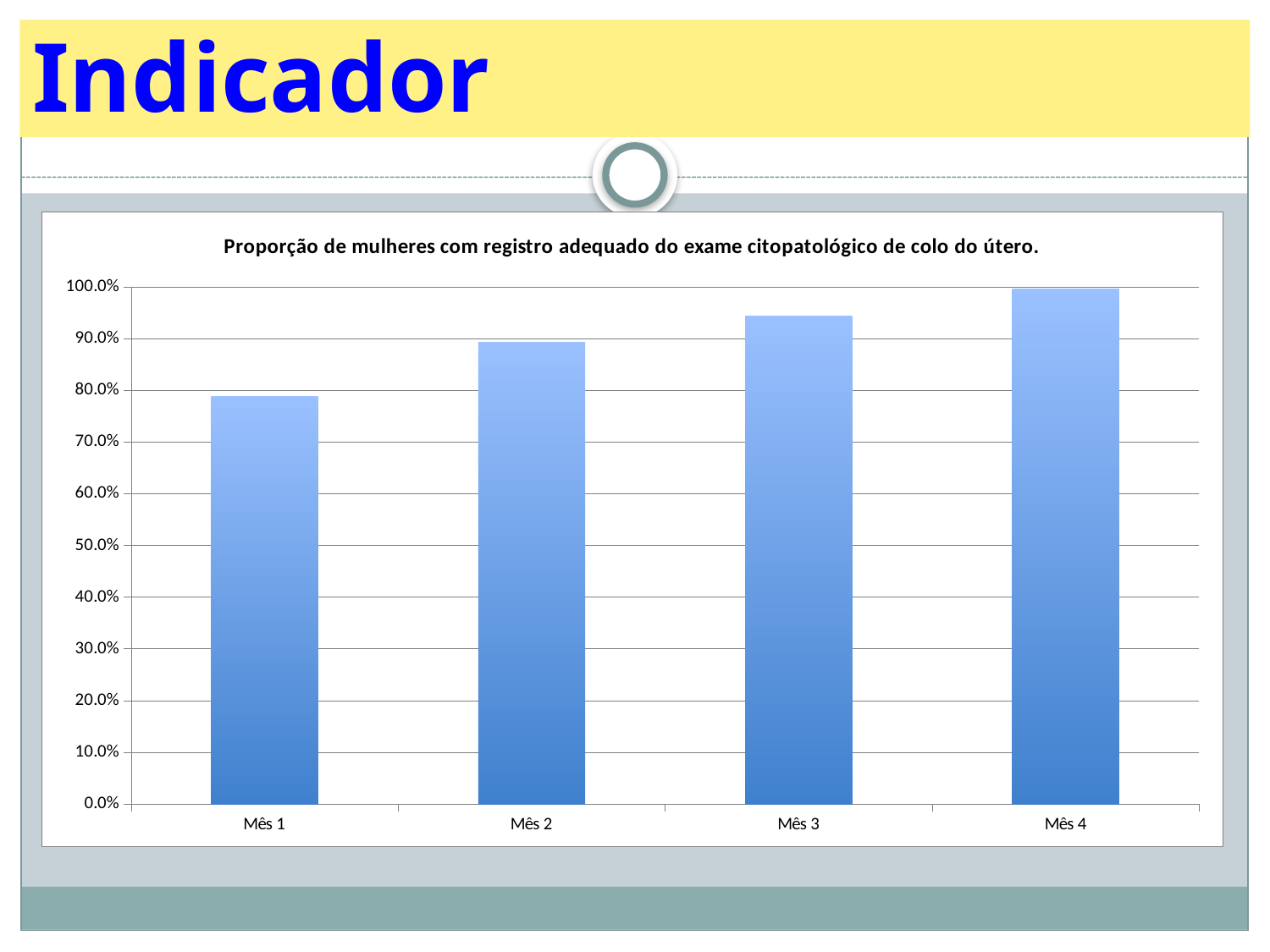
Which is larger, the value for Mês 2 or the value for Mês 4? Mês 4 Which month has the lowest proportion? Mês 1 Is the value for Mês 1 greater or less than 70.0%? greater Is the value for Mês 2 greater or less than 80.0%? greater Is the value for Mês 1 greater or less than 90.0%? less What kind of chart is shown on the slide? bar chart Do the values rise or fall from Mês 1 to Mês 4? rise Which is larger, the value for Mês 3 or the value for Mês 1? Mês 3 Which month has the highest proportion? Mês 4 How many categories (months) are plotted on the chart? 4 What is the title of the chart? Proporção de mulheres com registro adequado do exame citopatológico de colo do útero.